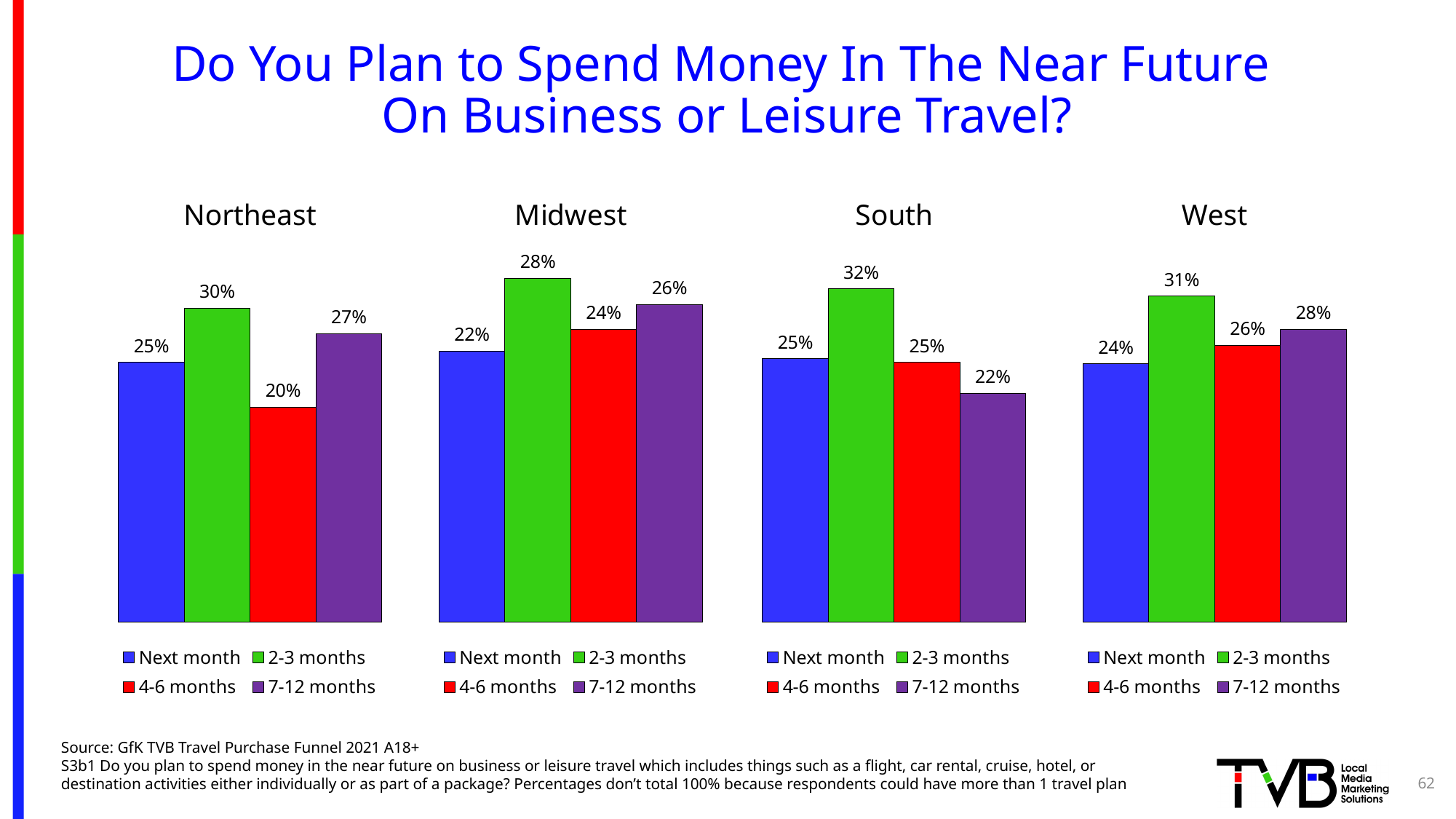
How many charts are shown on the slide? 4 What kind of chart is the South chart? bar chart In the Midwest chart, what is the value for Next month? 22% In the South chart, what is the value for 7-12 months? 22% In the Northeast chart, what is the value for 2-3 months? 30% In the Midwest chart, how many series does the legend list? 4 In the Northeast chart, which series has the lowest value? 4-6 months In the Northeast chart, what is the difference between the 2-3 months value and the 4-6 months value? 10% In the West chart, which is larger: the value for Next month or the value for 7-12 months? 7-12 months In the West chart, what colour are the 2-3 months bars? green In the South chart, which series has the highest value? 2-3 months In the West chart, what is the value for 4-6 months? 26%